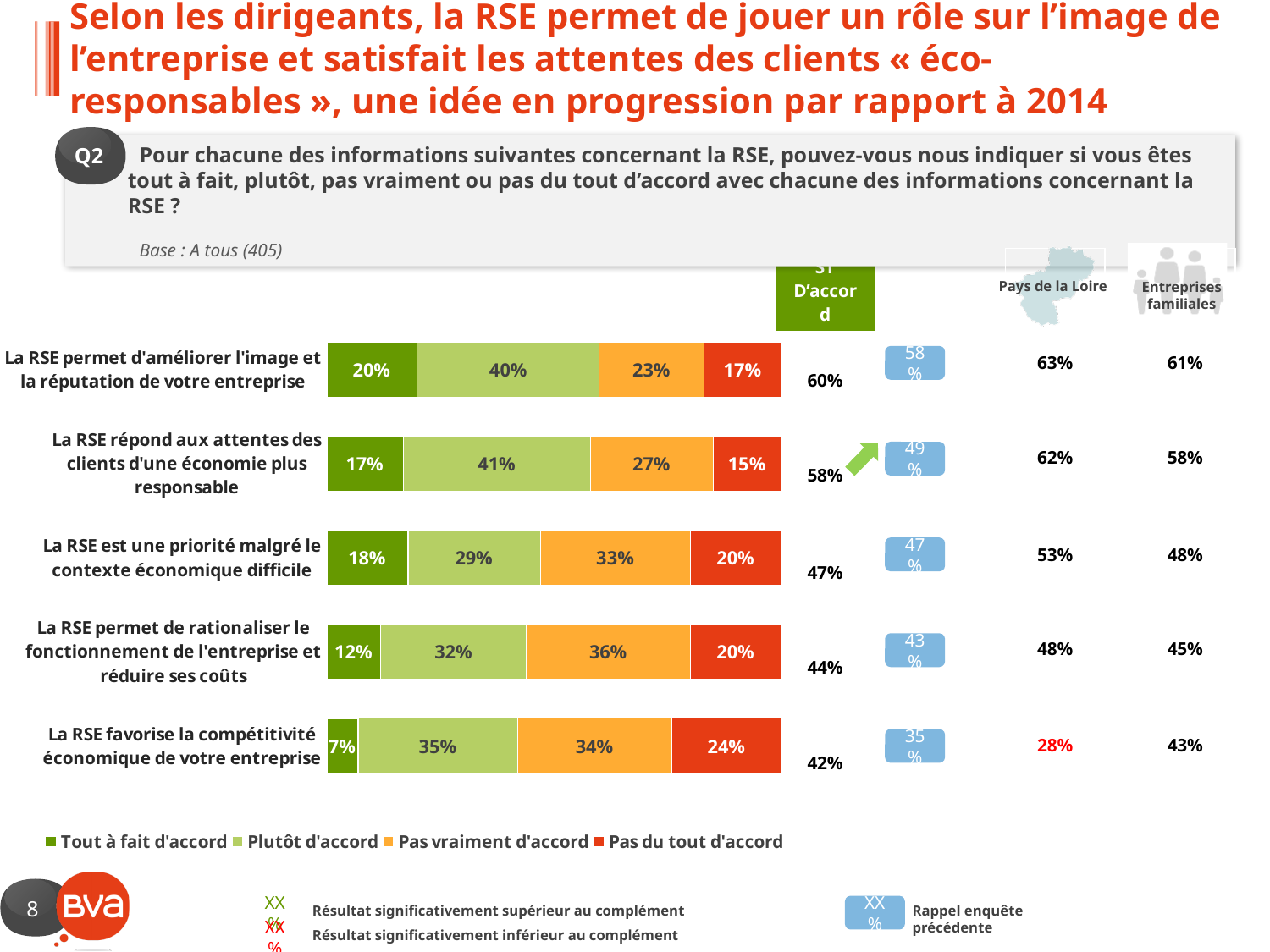
What is the combined total of 'Tout à fait d'accord' and 'Plutôt d'accord' for 'La RSE permet de rationaliser le fonctionnement de l'entreprise et réduire ses coûts'? 44% Which statement has the lowest 'Tout à fait d'accord' value? La RSE favorise la compétitivité économique de votre entreprise How many series does the legend list? 4 Which is larger: the 'Tout à fait d'accord' value for 'La RSE répond aux attentes des clients d'une économie plus responsable' or for 'La RSE est une priorité malgré le contexte économique difficile'? La RSE est une priorité malgré le contexte économique difficile Which legend entry is shown in dark green? Tout à fait d'accord What is the 'Pas vraiment d'accord' value for 'La RSE permet de rationaliser le fonctionnement de l'entreprise et réduire ses coûts'? 36% What is the 'Tout à fait d'accord' value for 'La RSE permet d'améliorer l'image et la réputation de votre entreprise'? 20% What kind of chart is shown on the slide? Stacked bar chart Which statement has the highest 'Plutôt d'accord' value? La RSE répond aux attentes des clients d'une économie plus responsable What is the 'Pas du tout d'accord' value for 'La RSE favorise la compétitivité économique de votre entreprise'? 24% What is the difference between the 'Pas vraiment d'accord' values for 'La RSE est une priorité malgré le contexte économique difficile' and 'La RSE permet d'améliorer l'image et la réputation de votre entreprise'? 10 percentage points How many statements (categories) are plotted in the chart? 5